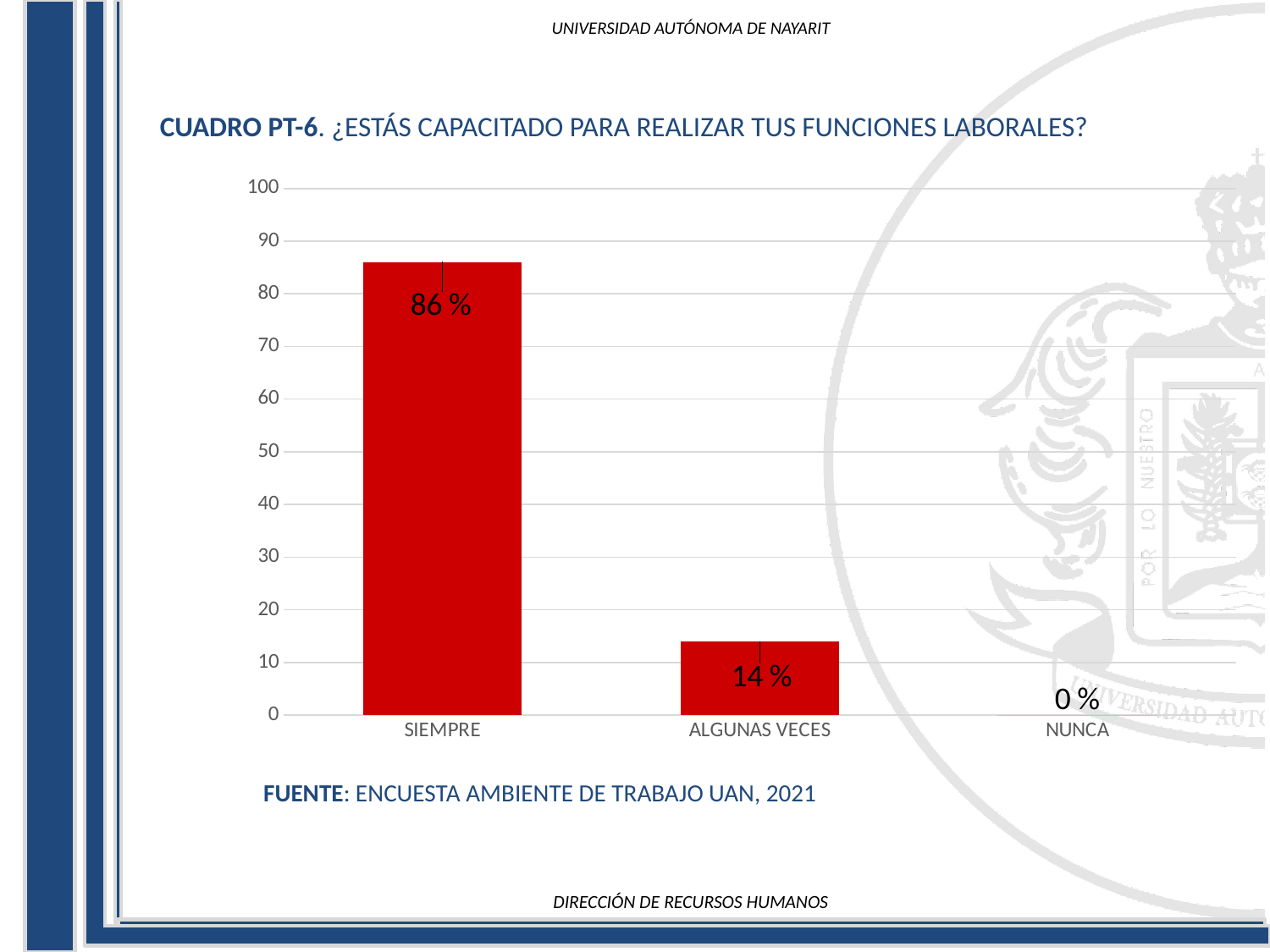
What is the value for NUNCA? 0 % Which is larger, the value for ALGUNAS VECES or the value for NUNCA? ALGUNAS VECES What is the value for SIEMPRE? 86 % Which category has the highest value? SIEMPRE What is the value for ALGUNAS VECES? 14 % What is the difference between the values for SIEMPRE and ALGUNAS VECES? 72 % What is the title of the chart? CUADRO PT-6. ¿ESTÁS CAPACITADO PARA REALIZAR TUS FUNCIONES LABORALES? Which category has the lowest value? NUNCA Is the value for ALGUNAS VECES greater or less than 20? less How many categories are shown on the x axis? 3 Is the value for SIEMPRE greater or less than 80? greater What kind of chart is shown on the slide? bar chart